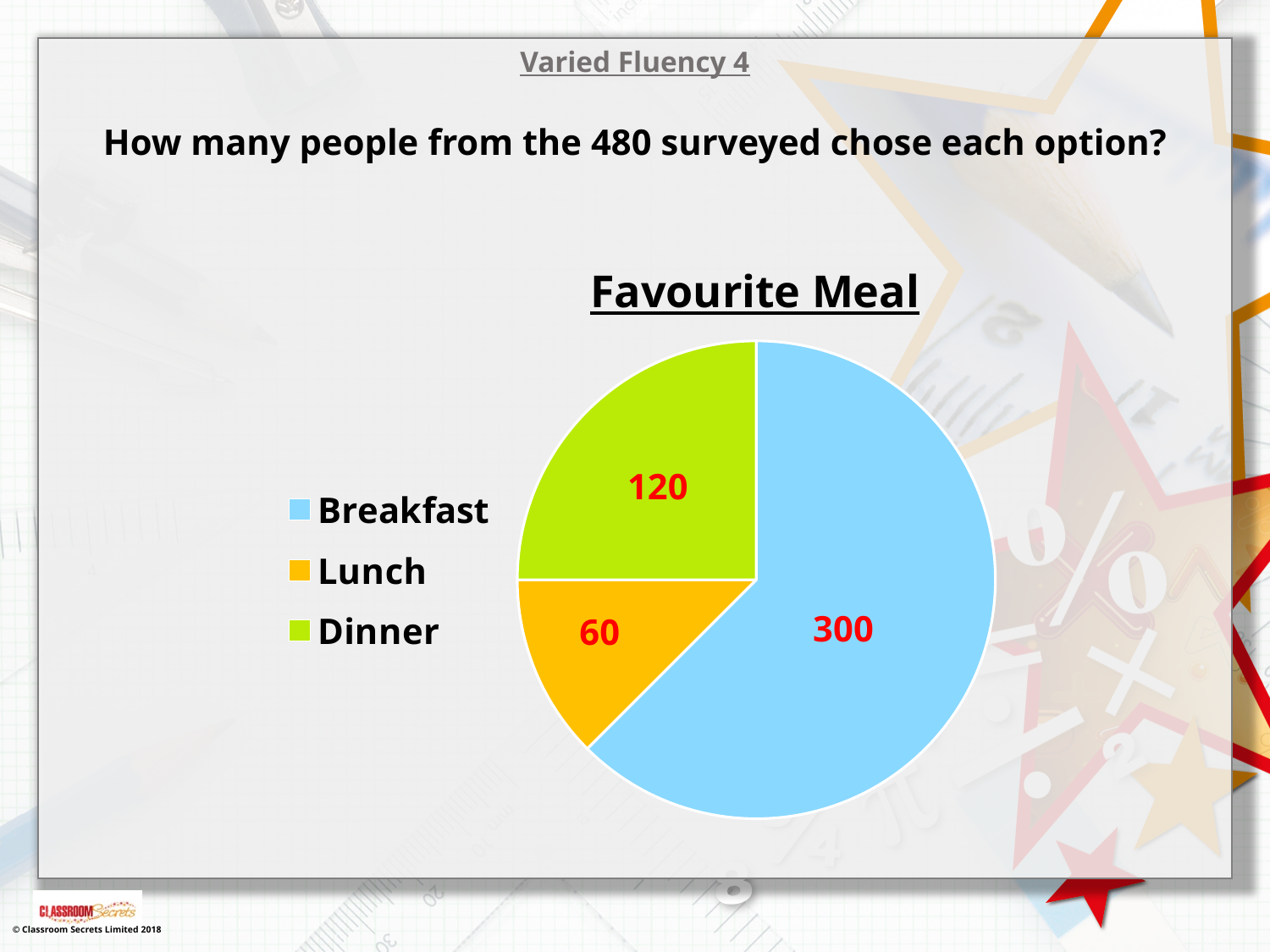
Which meal was chosen by the fewest people? Lunch How many more people chose Dinner than Lunch? 60 Which meal was chosen by the most people? Breakfast How many more people chose Breakfast than Dinner? 180 How many people chose Lunch? 60 How many people chose Dinner? 120 What is the title of the chart? Favourite Meal Which was chosen by more people, Lunch or Dinner? Dinner What share of the total does the Breakfast slice represent? 62.5% What type of chart is shown on the slide? pie chart How many people chose Breakfast? 300 How many categories does the pie chart show? 3